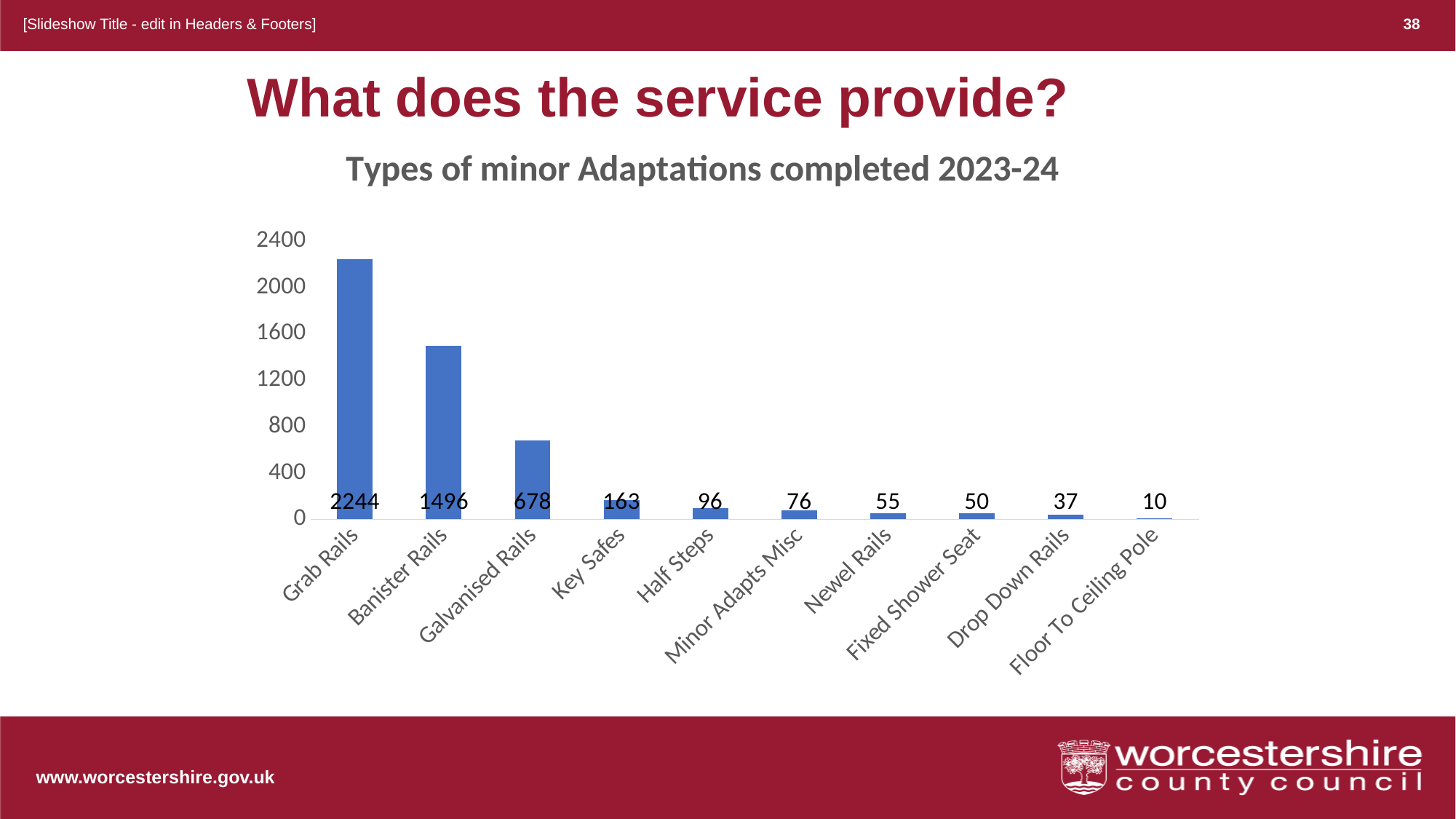
What kind of chart is shown on the slide? bar chart Which category has the lowest value? Floor To Ceiling Pole Which is larger, the value for Half Steps or the value for Minor Adapts Misc? Half Steps How many categories are shown on the x axis? 10 What is the title of the chart? Types of minor Adaptations completed 2023-24 Is the value for Galvanised Rails greater or less than 800? less What is the value for Key Safes? 163 What is the value for Banister Rails? 1496 What is the value for Fixed Shower Seat? 50 What is the value for Grab Rails? 2244 Which category has the highest value? Grab Rails What is the difference between the values for Grab Rails and Banister Rails? 748